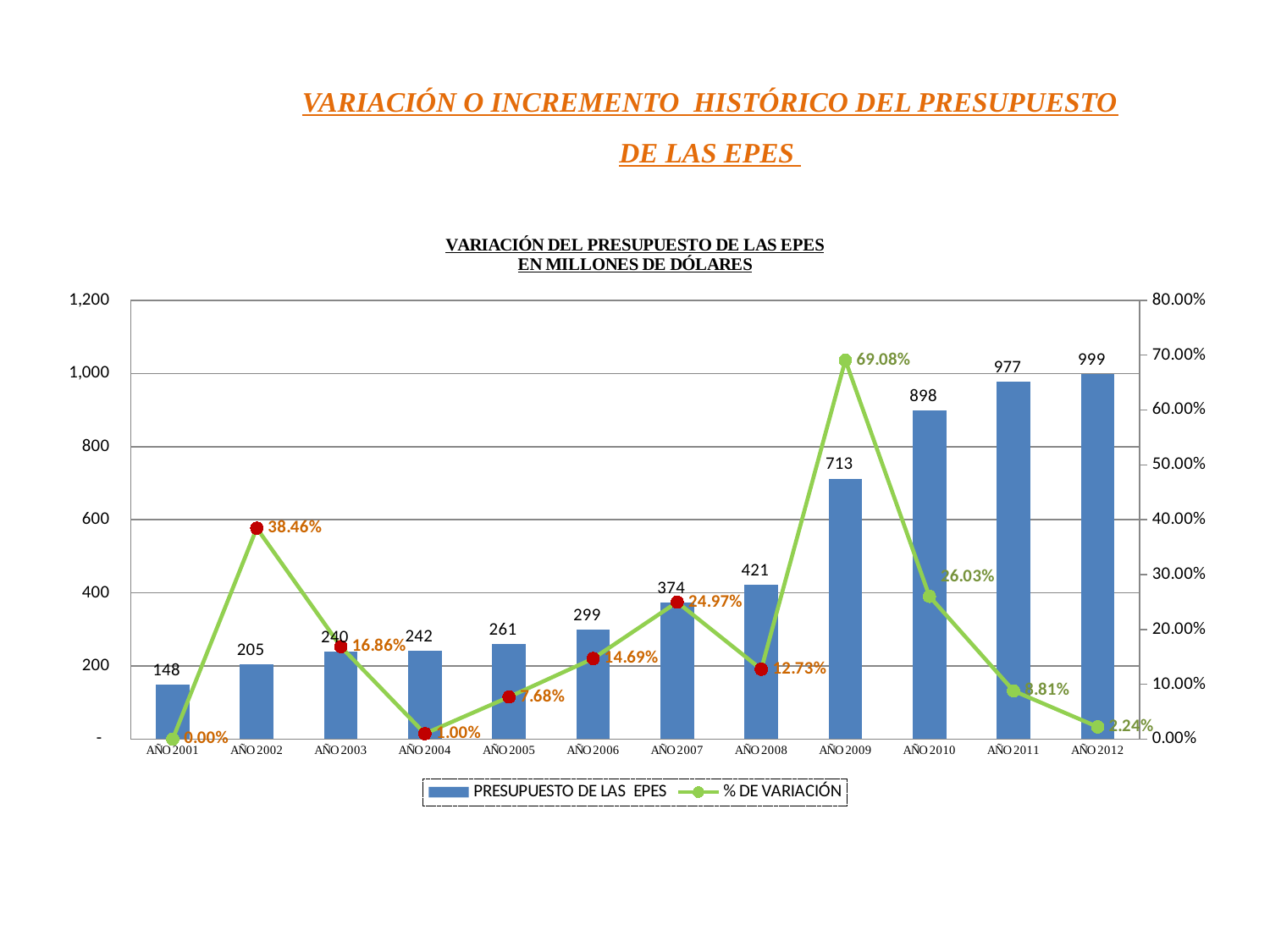
What is the % DE VARIACIÓN for AÑO 2002? 38.46% Do the PRESUPUESTO DE LAS EPES bars rise or fall from AÑO 2001 to AÑO 2012? Rise What is the value of PRESUPUESTO DE LAS EPES for AÑO 2009? 713 How many series does the legend list? 2 What kind of chart is shown? Combined bar and line chart Which year has the lowest PRESUPUESTO DE LAS EPES? AÑO 2001 How many years are shown on the x axis? 12 What is the value of PRESUPUESTO DE LAS EPES for AÑO 2001? 148 Which year has the highest % DE VARIACIÓN? AÑO 2009 What is the % DE VARIACIÓN for AÑO 2010? 26.03% Which is larger, the PRESUPUESTO DE LAS EPES for AÑO 2008 or for AÑO 2007? AÑO 2008 What is the difference in PRESUPUESTO DE LAS EPES between AÑO 2012 and AÑO 2011? 22